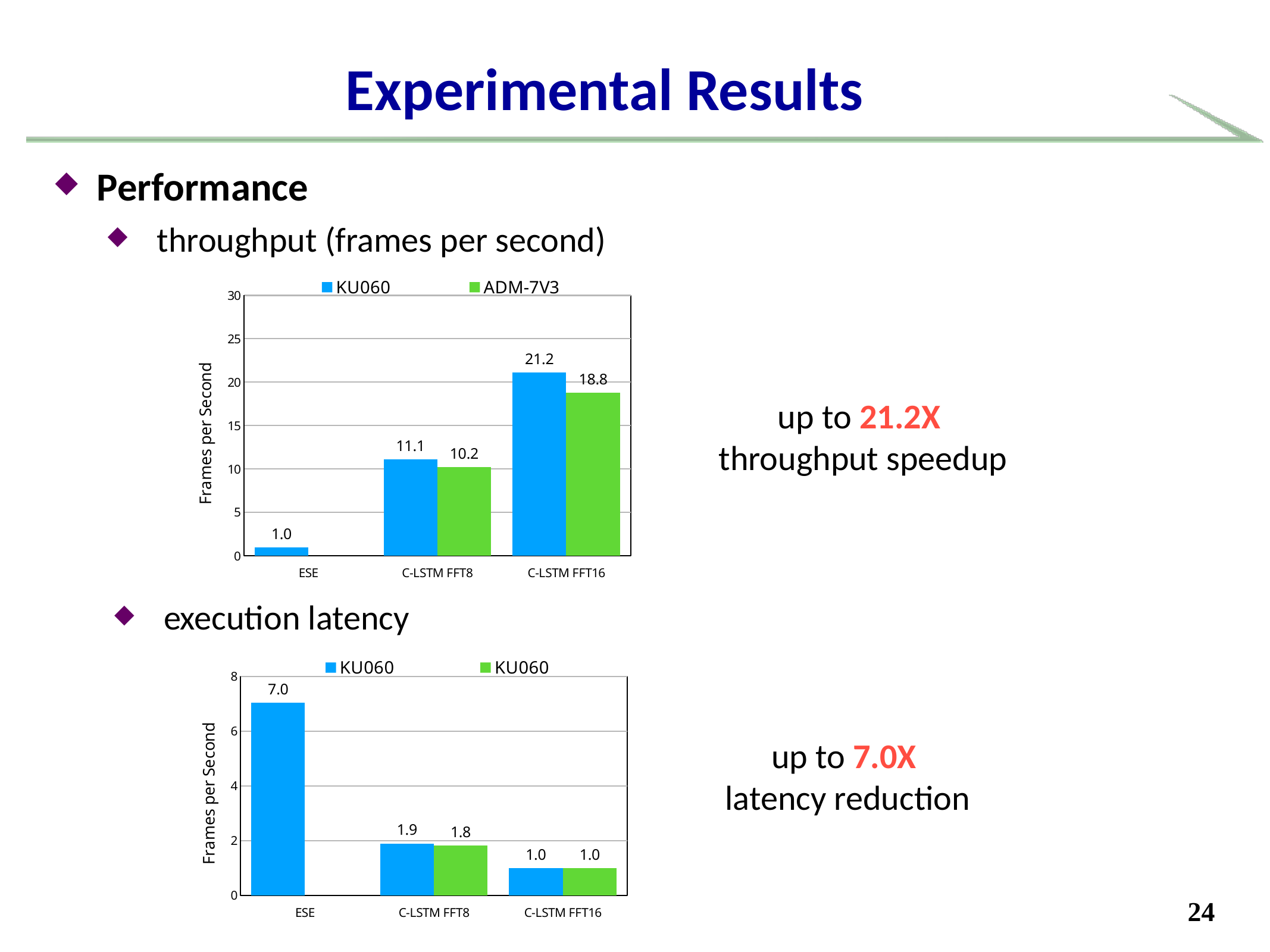
In the execution latency chart (bottom), which category has the lowest blue-series value? C-LSTM FFT16 What kind of chart is the execution latency chart (bottom)? bar chart In the execution latency chart (bottom), what is the blue-series value for ESE? 7.0 In the throughput chart (top), what is the KU060 value for C-LSTM FFT16? 21.2 In the execution latency chart (bottom), how many categories are shown on the x axis? 3 In the throughput chart (top), what is the difference between the KU060 and ADM-7V3 values for C-LSTM FFT16? 2.4 In the throughput chart (top), do the KU060 values rise or fall from ESE to C-LSTM FFT16? rise In the throughput chart (top), how many series does the legend list? 2 In the throughput chart (top), which category has the highest KU060 value? C-LSTM FFT16 In the throughput chart (top), what is the value for ESE? 1.0 In the execution latency chart (bottom), what is the green-series value for C-LSTM FFT8? 1.8 In the throughput chart (top), what is the ADM-7V3 value for C-LSTM FFT8? 10.2